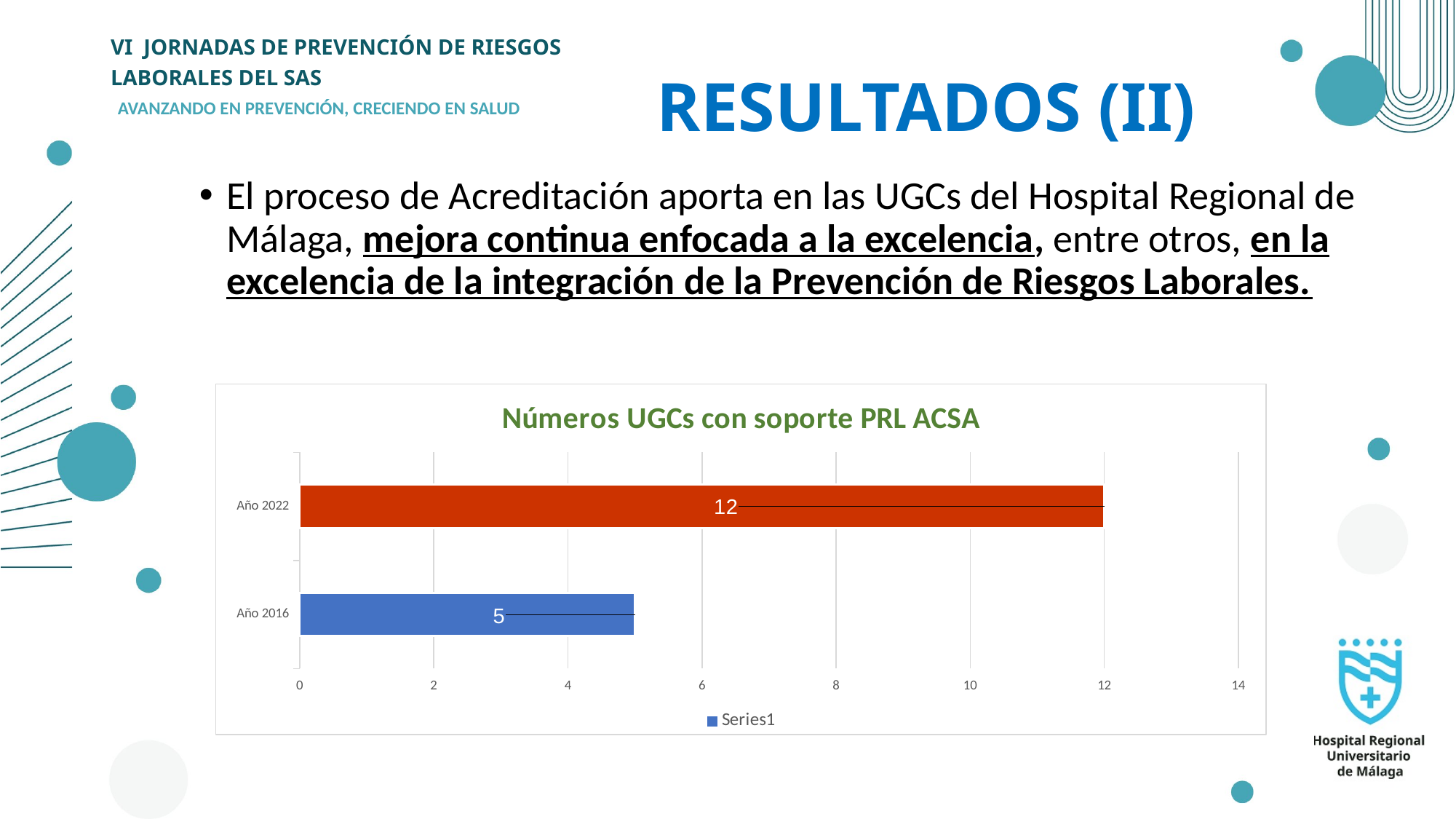
Is the value for Año 2016 greater or less than 6? less Which is larger, the value for Año 2016 or the value for Año 2022? Año 2022 What is the title of the chart? Números UGCs con soporte PRL ACSA How many categories are shown in the chart? 2 Is the value for Año 2022 greater or less than 10? greater What is the value for Año 2022? 12 Which category has the highest value? Año 2022 What is the value for Año 2016? 5 What is the difference between the values for Año 2022 and Año 2016? 7 Which category has the lowest value? Año 2016 What kind of chart is shown on the slide? Bar chart How many series does the legend list? 1